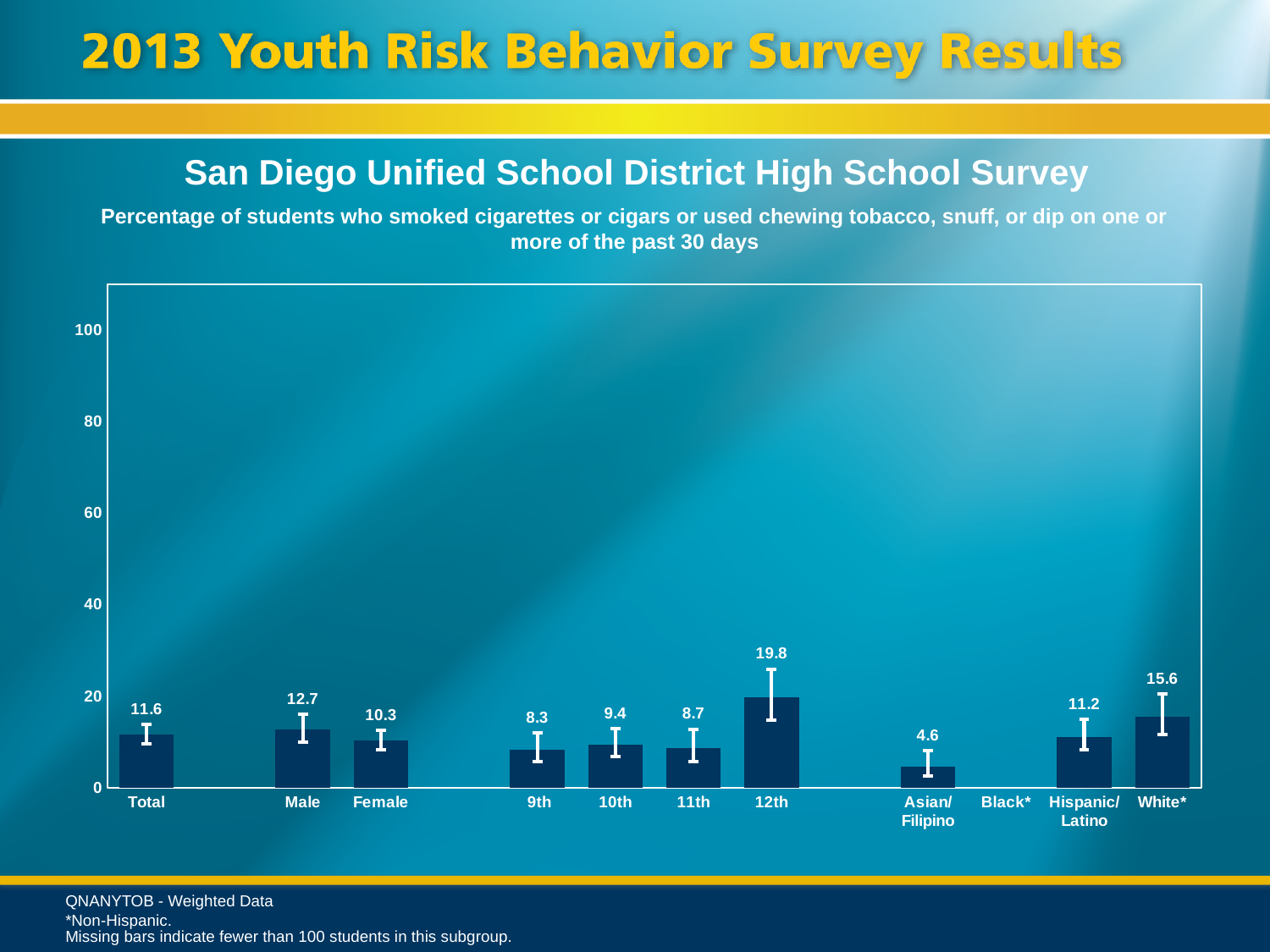
Which category has the highest value? 12th What is the value for Total? 11.6 Do the values rise or fall from 9th grade to 12th grade overall? rise What is the value for 12th grade? 19.8 What is the difference between the Male and Female values? 2.4 Which category with a bar has the lowest value? Asian/Filipino Is the value for White* greater or less than 20? less What kind of chart is shown? bar chart What is the value for Asian/Filipino students? 4.6 Which is larger, the value for 10th grade or 11th grade? 10th What is the value for Hispanic/Latino students? 11.2 Which category has no bar shown? Black*